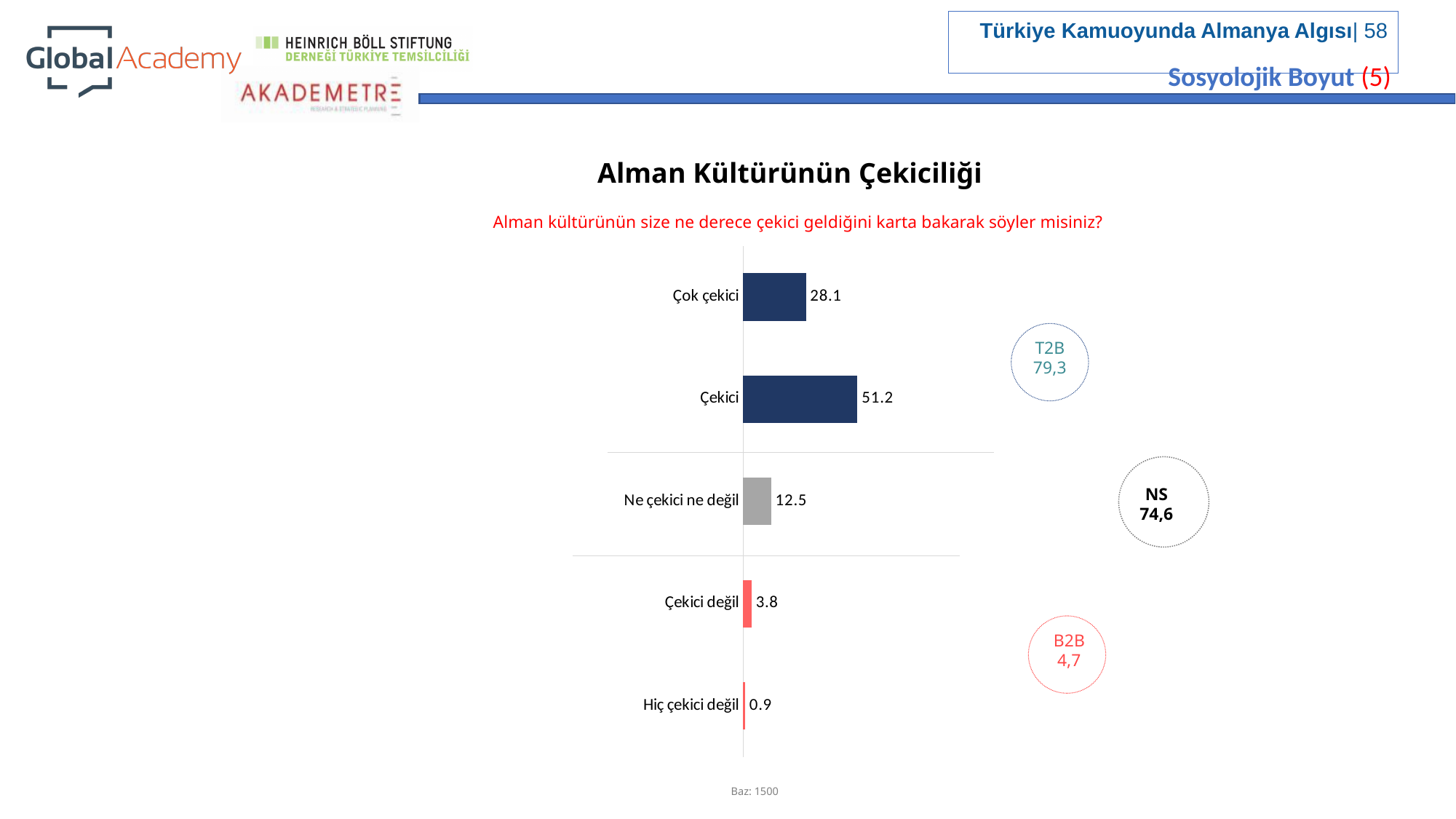
Which category has the lowest value? Hiç çekici değil What is the title of the chart? Alman Kültürünün Çekiciliği Which category has the highest value? Çekici What is the value for "Ne çekici ne değil"? 12.5 What is the difference between the values for "Çekici değil" and "Hiç çekici değil"? 2.9 What is the value for "Hiç çekici değil"? 0.9 What kind of chart is shown on the slide? Bar chart Which is larger, the value for "Ne çekici ne değil" or the value for "Çekici değil"? Ne çekici ne değil How many categories are shown in the chart? 5 What is the value for "Çekici"? 51.2 What is the T2B value shown next to the chart? 79,3 What is the difference between the values for "Çekici" and "Çok çekici"? 23.1